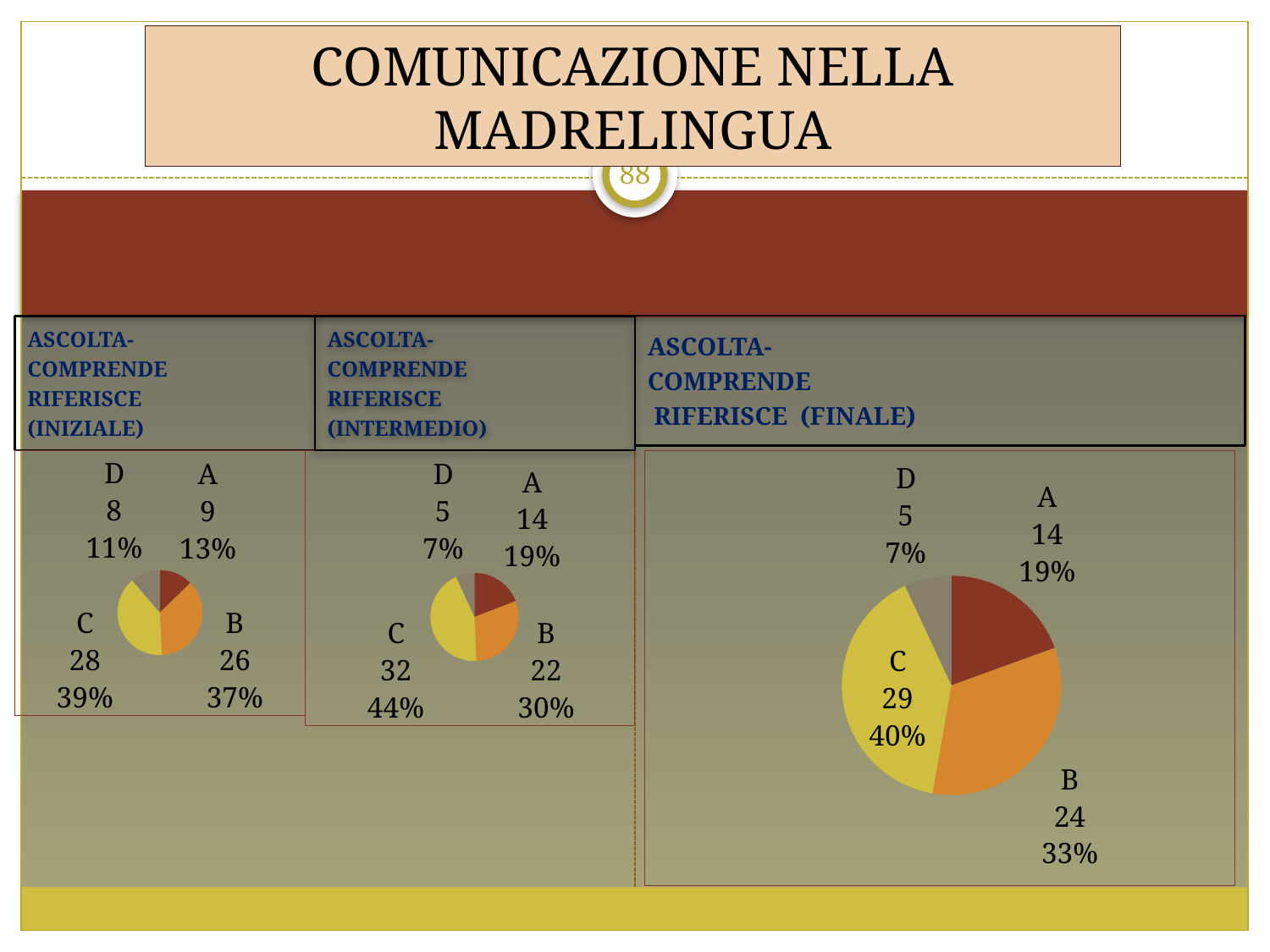
In the ASCOLTA-COMPRENDE RIFERISCE (INIZIALE) chart, which category has the lowest value? D In the ASCOLTA-COMPRENDE RIFERISCE (FINALE) chart, what percentage share does category D have? 7% In the ASCOLTA-COMPRENDE RIFERISCE (INTERMEDIO) chart, what is the difference between the values for C and B? 10 What type of chart is the ASCOLTA-COMPRENDE RIFERISCE (FINALE) chart? Pie chart In the ASCOLTA-COMPRENDE RIFERISCE (INTERMEDIO) chart, which category has the highest value? C In the ASCOLTA-COMPRENDE RIFERISCE (INTERMEDIO) chart, what percentage share does category C have? 44% How many categories does the ASCOLTA-COMPRENDE RIFERISCE (FINALE) chart show? 4 In the ASCOLTA-COMPRENDE RIFERISCE (INIZIALE) chart, what is the value for category C? 28 In the ASCOLTA-COMPRENDE RIFERISCE (FINALE) chart, which is larger, the value for A or the value for C? C In the ASCOLTA-COMPRENDE RIFERISCE (INIZIALE) chart, what percentage share does category B have? 37% In the ASCOLTA-COMPRENDE RIFERISCE (FINALE) chart, what is the value for category B? 24 In the ASCOLTA-COMPRENDE RIFERISCE (INTERMEDIO) chart, what is the value for category A? 14